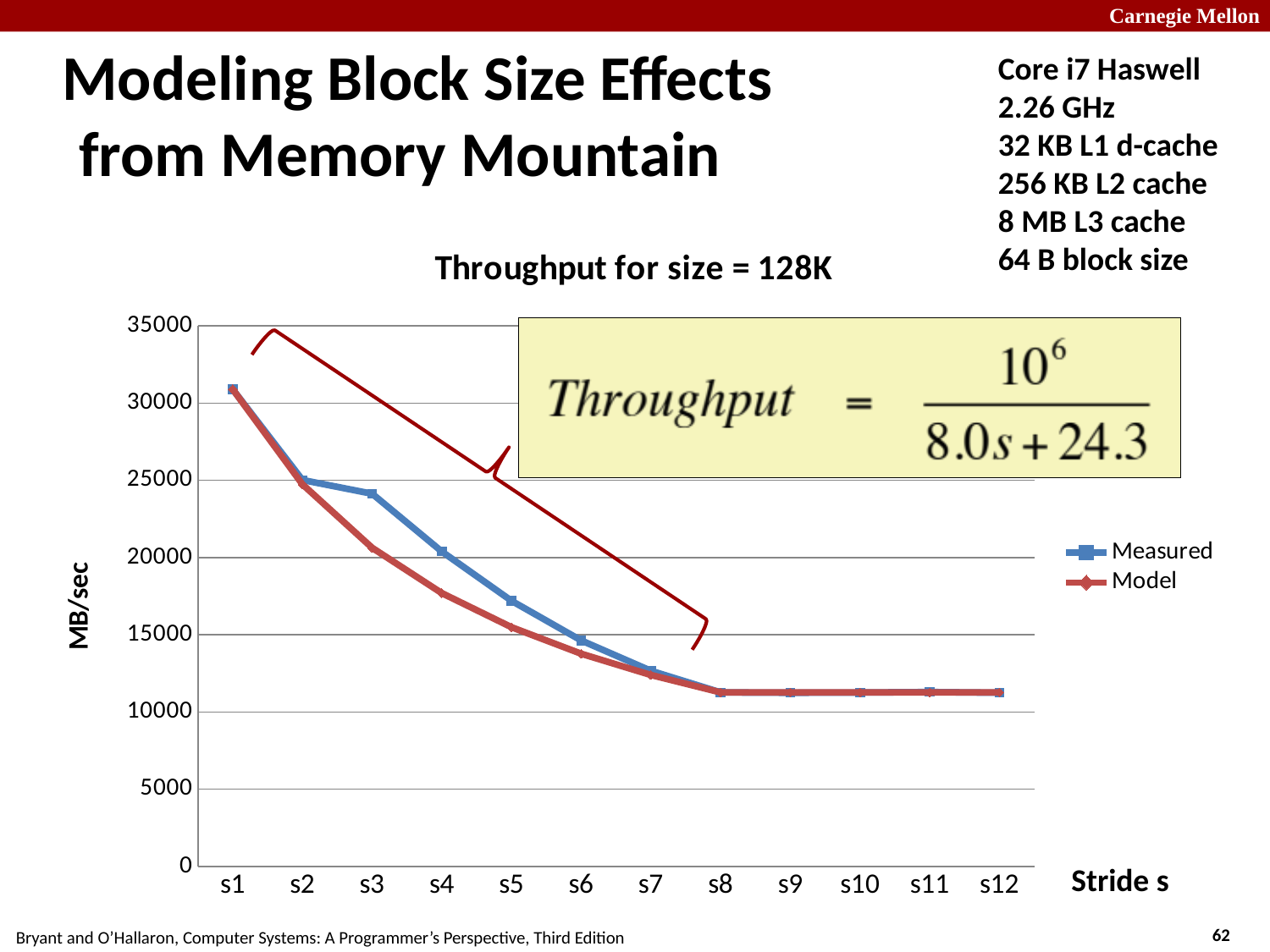
At stride s3, which series has the larger value, Measured or Model? Measured How many series does the legend list? 2 Is the Measured value at s8 greater or less than 10000? greater How many stride values are plotted along the x axis? 12 What are the two series named in the legend? Measured and Model What kind of chart is shown on the slide? line chart What is the title of the chart? Throughput for size = 128K Is the Measured value at s3 greater or less than 25000? less Do the throughput values rise or fall as the stride increases from s1 to s8? fall Is the Model value at s4 greater or less than 20000? less At which stride is the Measured throughput highest? s1